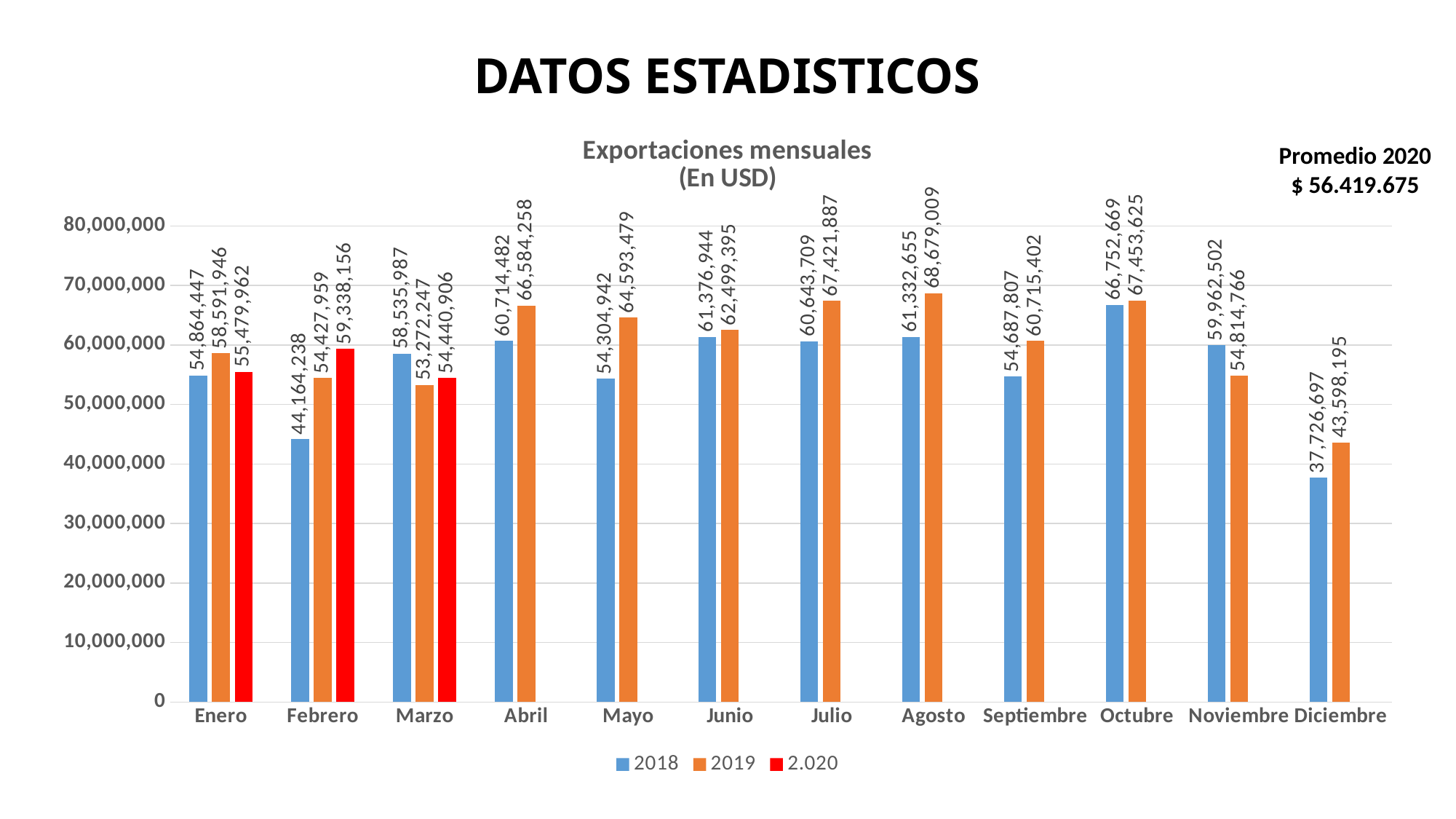
Is the value for 2019 in Diciembre greater or less than 50,000,000? less How many series does the legend list? 3 Which is larger in Noviembre, the 2018 value or the 2019 value? 2018 What is the value for 2.020 in Marzo? 54,440,906 How many months are shown on the x axis? 12 What kind of chart is shown on the slide? bar chart What is the value for 2018 in Febrero? 44,164,238 Which month has the lowest value for the 2018 series? Diciembre What is the value for 2019 in Agosto? 68,679,009 What is the title of the chart? Exportaciones mensuales (En USD) Which month has the highest value for the 2019 series? Agosto What is the difference between the 2.020 and 2018 values in Febrero? 15,173,918